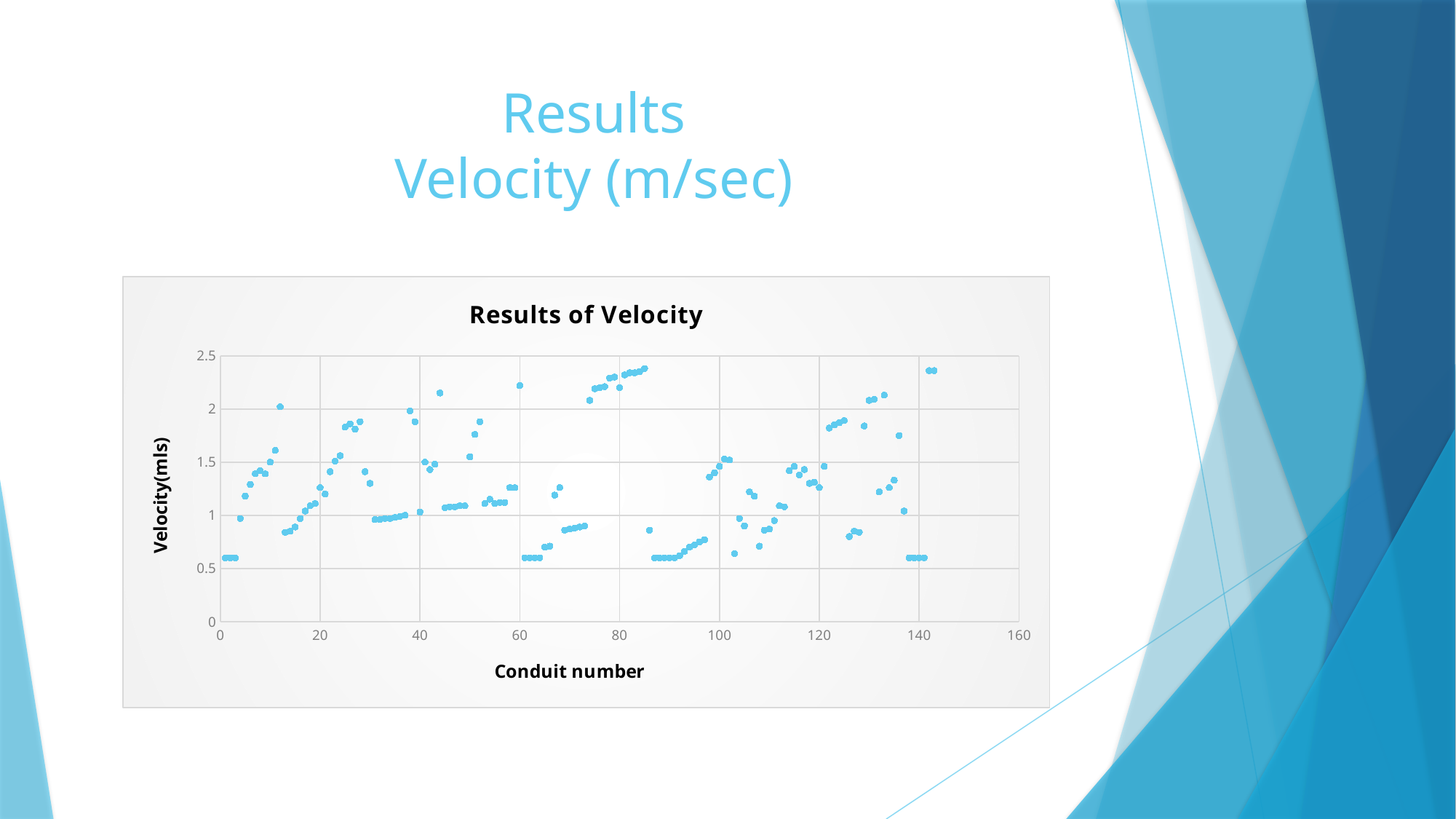
Is the velocity for conduit number 1 greater or less than 1? less Is the velocity for conduit number 140 greater or less than 1? less Is the velocity for conduit number 60 greater or less than 2? greater What is the title of the chart? Results of Velocity What kind of chart is shown on the slide? scatter chart Which has the higher velocity, conduit number 60 or conduit number 62? conduit number 60 What is the label of the x axis of the chart? Conduit number Which has the lower velocity, conduit number 85 or conduit number 88? conduit number 88